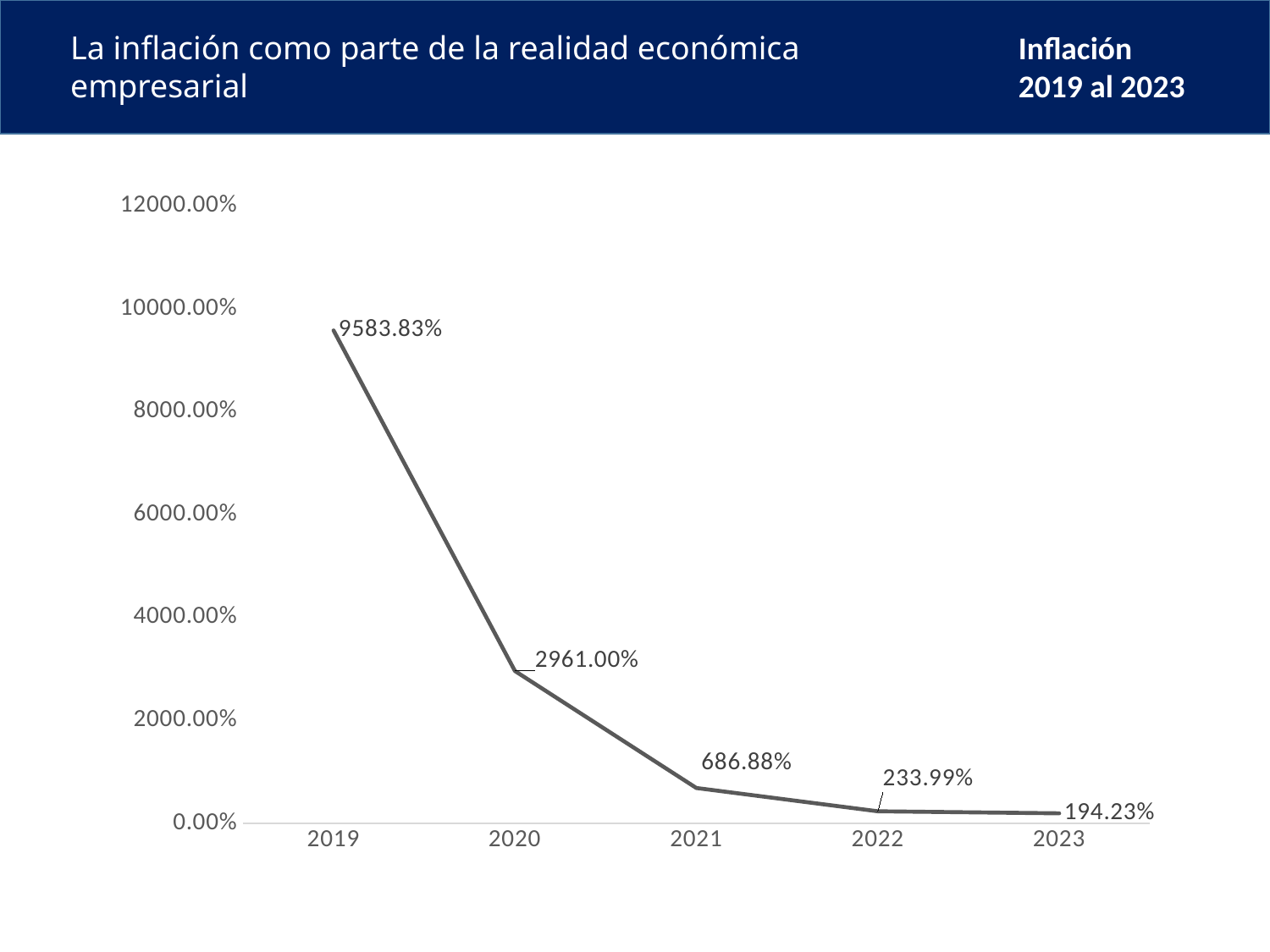
Which year has the highest inflation value? 2019 Do the inflation values rise or fall from 2019 to 2023? Fall Which is larger, the inflation value for 2020 or for 2021? 2020 What is the difference between the inflation values for 2022 and 2023? 39.76% Which year has the lowest inflation value? 2023 What is the inflation value shown for 2022? 233.99% What is the inflation value shown for 2021? 686.88% What kind of chart is shown on the slide? Line chart What is the inflation value shown for 2019? 9583.83% What is the inflation value shown for 2023? 194.23% What is the difference between the inflation values for 2019 and 2020? 6622.83% How many years are plotted on the x axis? 5